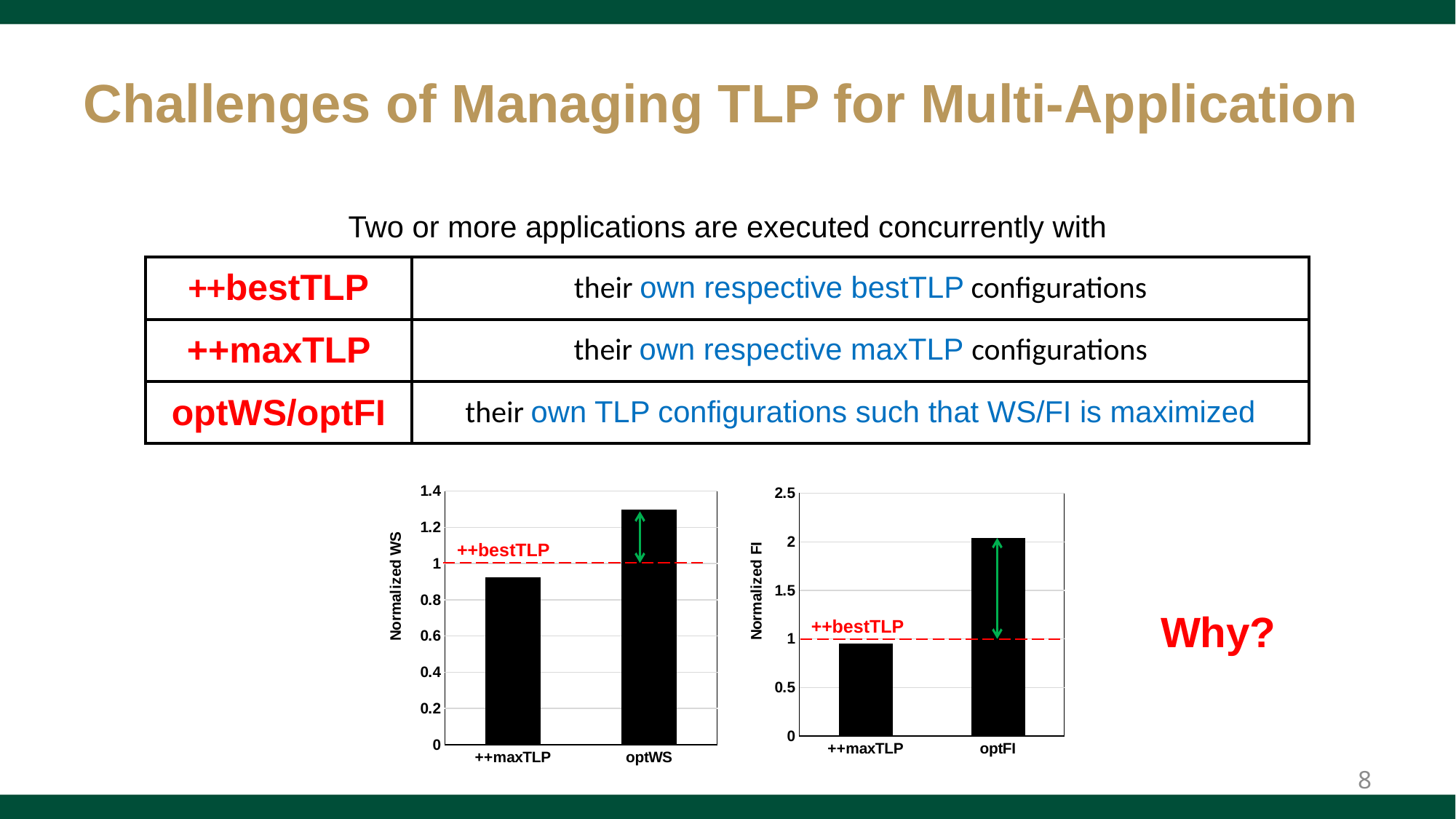
In the left chart (Normalized WS), which category has the higher bar? optWS In the right chart (Normalized FI), which category has the lower bar? ++maxTLP In the right chart, which is larger: the value for ++maxTLP or the value for optFI? optFI What is the maximum value shown on the y-axis of the right chart (Normalized FI)? 2.5 How many bars are plotted in the right chart (Normalized FI)? 2 In the left chart (Normalized WS), is the value for optWS greater or less than 1.2? greater What kind of chart is the left chart (Normalized WS)? bar chart What label is attached to the red dashed horizontal line in the left chart? ++bestTLP In the left chart (Normalized WS), is the value for ++maxTLP greater or less than 1? less What is the label of the y-axis on the right chart? Normalized FI